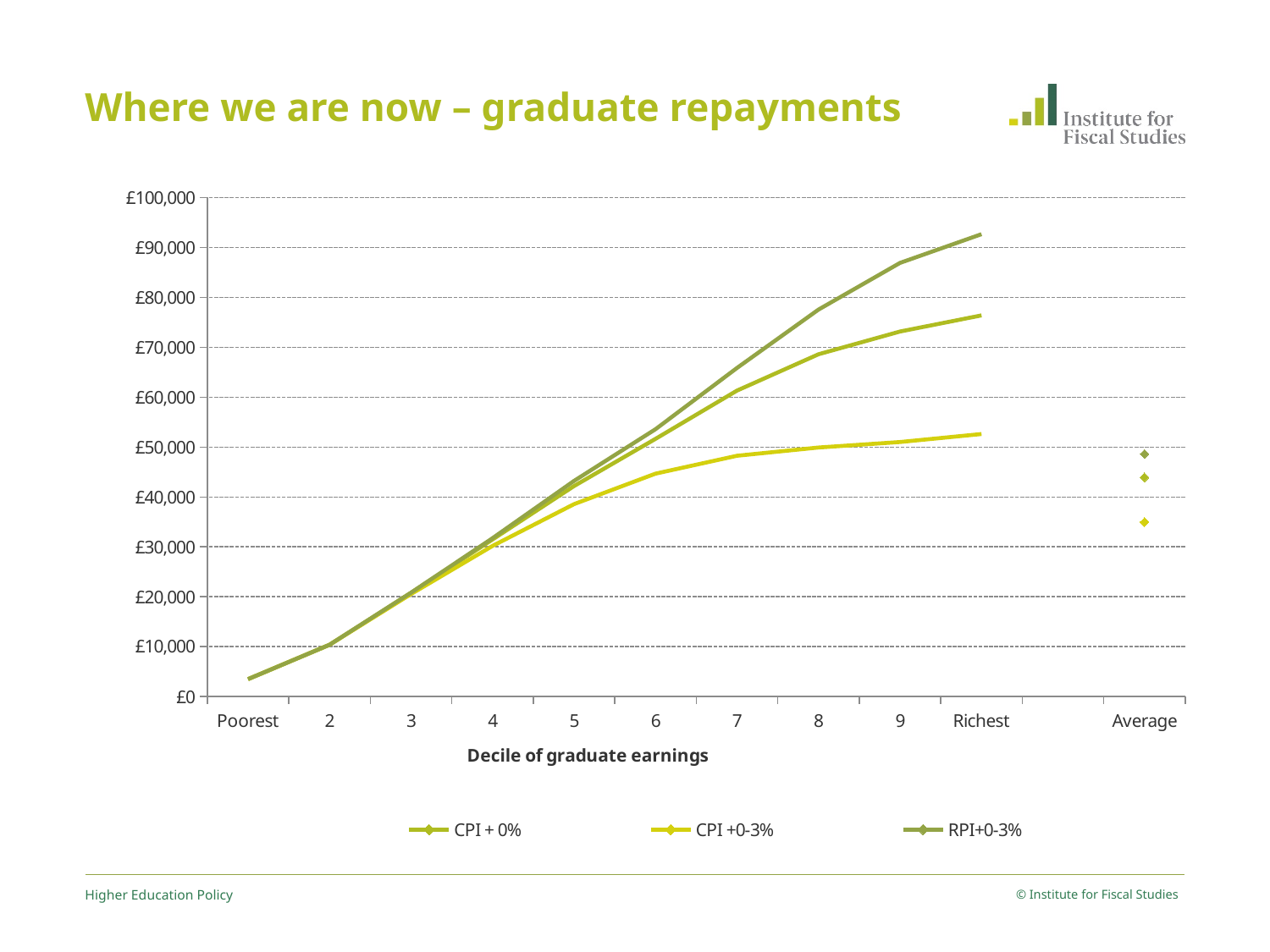
How many decile categories are plotted along the x axis, from Poorest to Richest (excluding Average)? 10 How many series does the legend list? 3 At decile 8, which is larger: CPI + 0% or CPI +0-3%? CPI + 0% Which series has the highest value at the Richest decile? RPI+0-3% Which series has the lowest value at the Richest decile? CPI +0-3% What type of chart is shown on the slide? Line chart Is the value for RPI+0-3% at the Richest decile greater or less than £90,000? greater Is the value for CPI + 0% at the Richest decile greater or less than £70,000? greater Is the value for CPI +0-3% at the Richest decile greater or less than £60,000? less Do the repayment values rise or fall as you move from the Poorest decile to the Richest decile? Rise What is the title of the x axis? Decile of graduate earnings